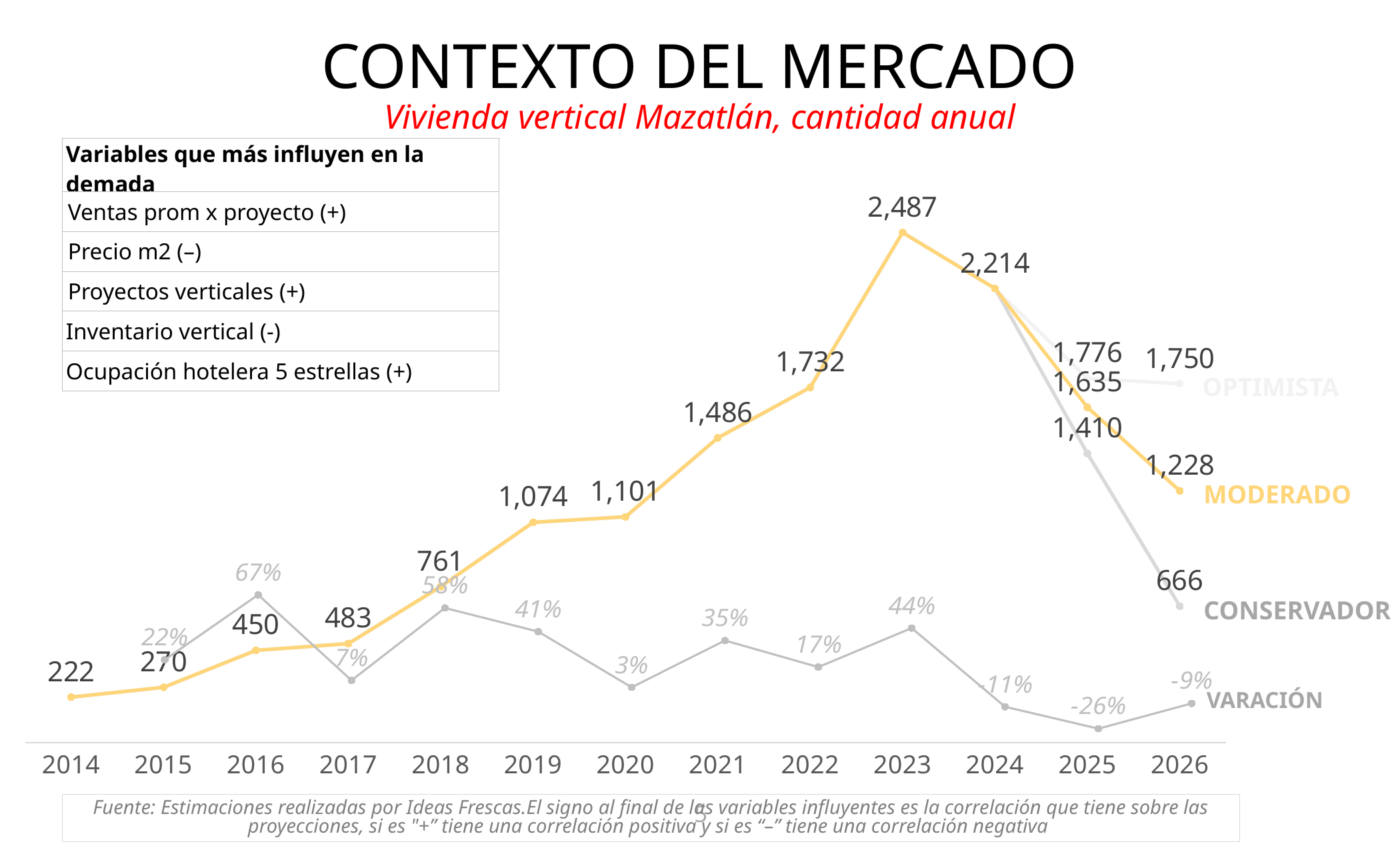
What is the OPTIMISTA value for 2026? 1,750 Which is larger, the 2019 value or the 2020 value? 2020 What is the VARIACIÓN percentage for 2016? 67% What is the value for 2014? 222 Which year has the highest value on the main line? 2023 What type of chart is shown on the slide? line chart What is the value for 2023 on the main (MODERADO) line? 2,487 What is the subtitle of the chart shown in red? Vivienda vertical Mazatlán, cantidad anual What is the CONSERVADOR value for 2026? 666 What is the difference between the 2023 value (2,487) and the 2024 value (2,214)? 273 Which year has the lowest value on the main line? 2014 How many years are shown on the x axis? 13